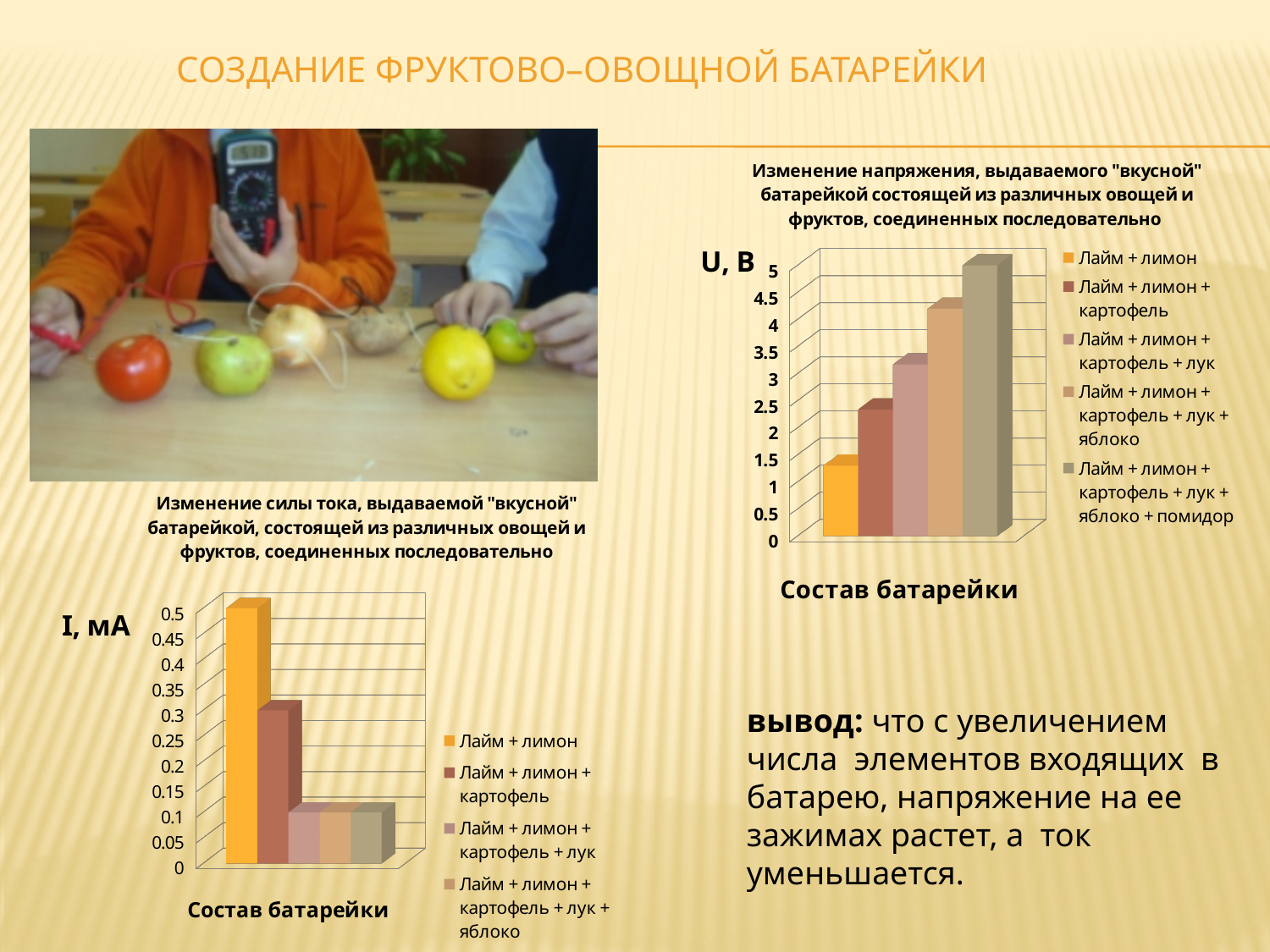
In the top-right voltage chart, is the value for Лайм + лимон + картофель + лук + яблоко + помидор greater or less than 4? greater In the bottom-left current chart, is the value for Лайм + лимон + картофель greater or less than 0.2? greater In the top-right voltage chart, which battery composition gives the lowest voltage? Лайм + лимон In the top-right voltage chart, which battery composition gives the highest voltage? Лайм + лимон + картофель + лук + яблоко + помидор In the top-right voltage chart, do the values rise or fall as more elements are added to the battery? rise In the bottom-left current chart, do the values rise or fall as more elements are added to the battery? fall How many bars are plotted in the bottom-left current chart? 5 What is the y-axis label of the top-right voltage chart? U, В What kind of chart is the top-right chart about voltage (напряжение)? bar chart In the top-right voltage chart, is the value for Лайм + лимон greater or less than 1? greater How many series does the legend of the top-right voltage chart list? 5 In the bottom-left current chart, which battery composition gives the highest current? Лайм + лимон